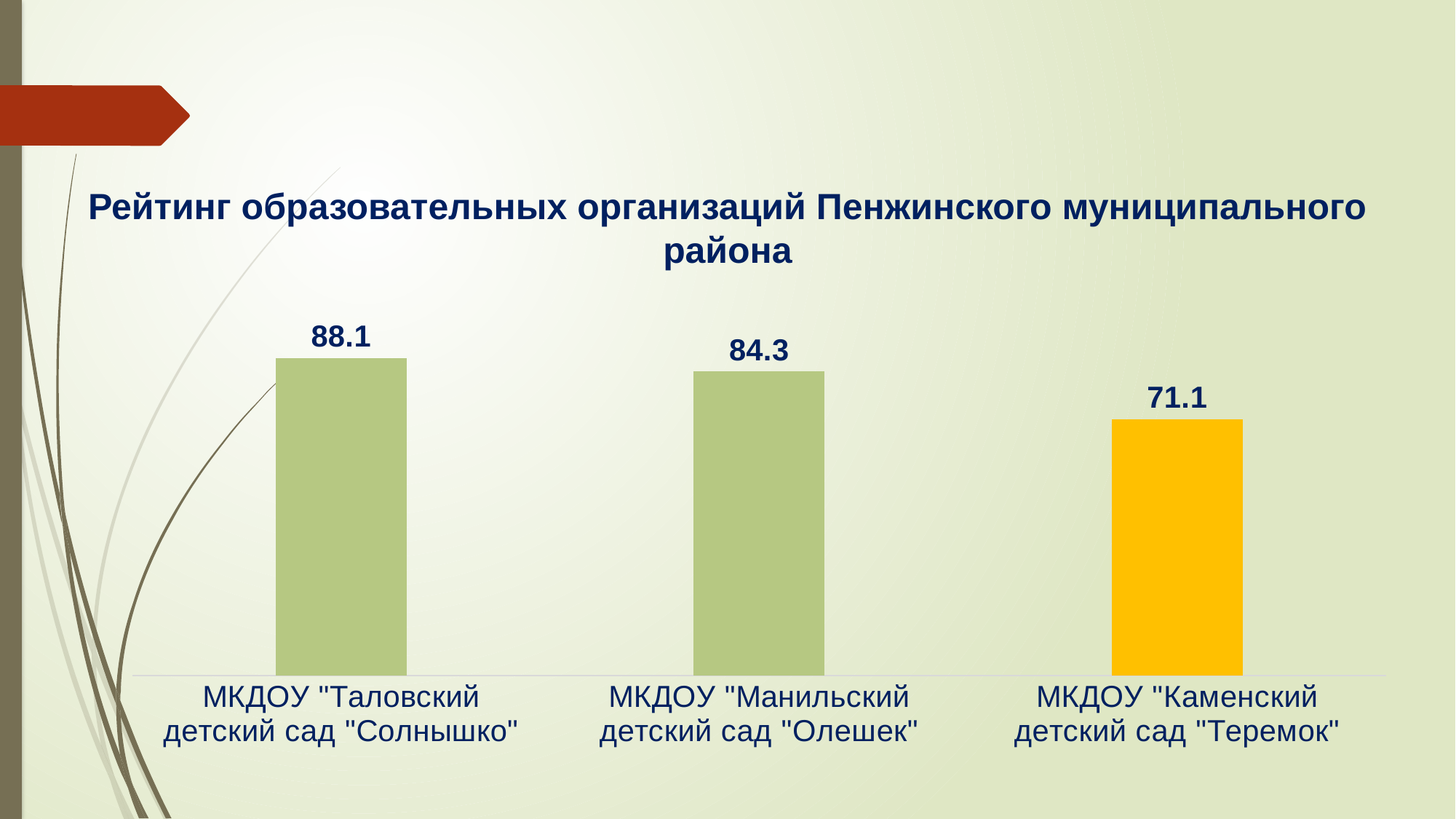
What is the value for МКДОУ "Манильский детский сад "Олешек"? 84.3 Which organisation has the highest value? МКДОУ "Таловский детский сад "Солнышко" What is the difference between the values for МКДОУ "Таловский детский сад "Солнышко" and МКДОУ "Каменский детский сад "Теремок"? 17.0 How many organisations are shown in the chart? 3 What is the value for МКДОУ "Каменский детский сад "Теремок"? 71.1 What kind of chart is shown on the slide? Bar chart Which has a larger value: МКДОУ "Манильский детский сад "Олешек" or МКДОУ "Каменский детский сад "Теремок"? МКДОУ "Манильский детский сад "Олешек" Do the values rise or fall from left to right across the chart? Fall What is the value for МКДОУ "Таловский детский сад "Солнышко"? 88.1 What is the difference between the values for МКДОУ "Таловский детский сад "Солнышко" and МКДОУ "Манильский детский сад "Олешек"? 3.8 What is the title of the chart? Рейтинг образовательных организаций Пенжинского муниципального района Which organisation has the lowest value? МКДОУ "Каменский детский сад "Теремок"